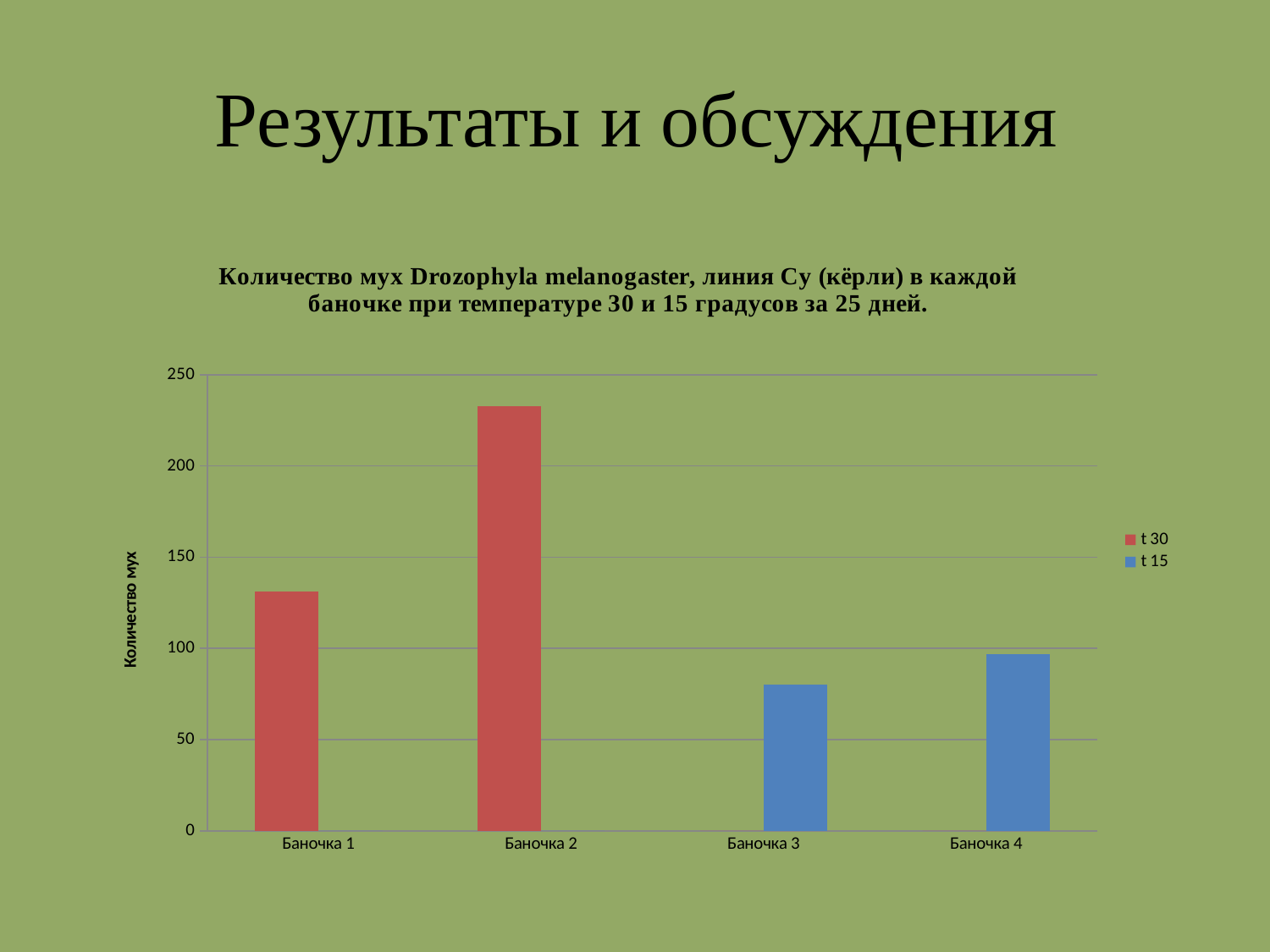
Is the value for Баночка 4 greater or less than 50? greater Is the value for Баночка 2 greater or less than 200? greater Is the value for Баночка 3 greater or less than 100? less What is the label of the vertical axis of the chart? Количество мух What kind of chart is shown on the slide? bar chart Which series in the legend is shown in red? t 30 Which is larger, the value for Баночка 1 or the value for Баночка 4? Баночка 1 Which category has the highest bar in the chart? Баночка 2 How many categories (баночки) are shown on the x axis of the chart? 4 How many series does the chart legend list? 2 Which category has the lowest bar in the chart? Баночка 3